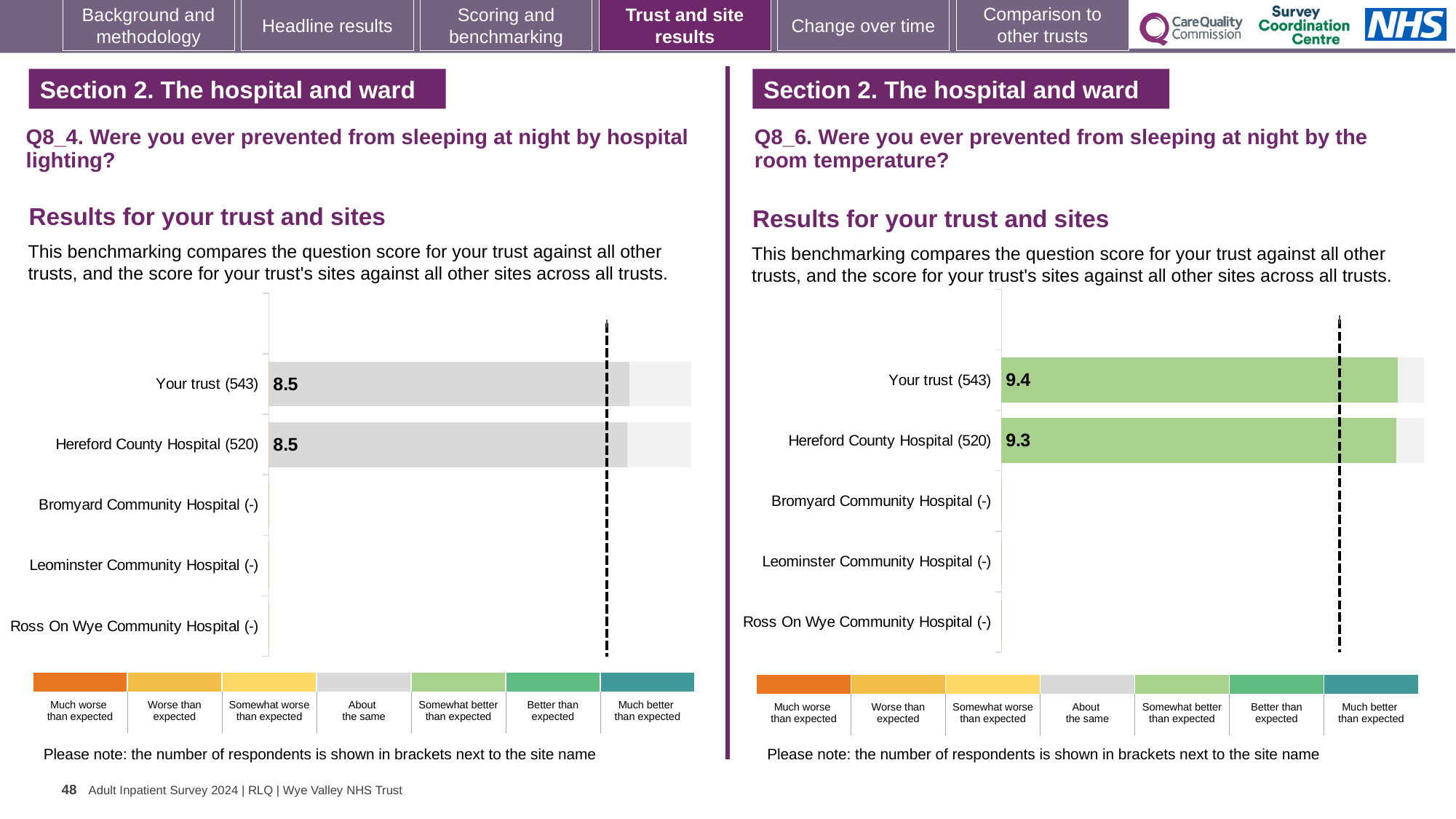
In the Q8_4 chart (hospital lighting), what is the score for Your trust? 8.5 What type of chart is used in the Q8_6 chart (room temperature)? Bar chart In the Q8_6 chart (room temperature), what is the score for Your trust? 9.4 In the Q8_6 chart (room temperature), which benchmark category does the colour of the Your trust bar correspond to according to the legend? Somewhat better than expected How many respondents are shown in brackets for Hereford County Hospital in the Q8_4 chart (hospital lighting)? 520 In the Q8_4 chart (hospital lighting), what is the score for Hereford County Hospital? 8.5 What is the difference between the Your trust score in the Q8_6 chart (room temperature) and the Your trust score in the Q8_4 chart (hospital lighting)? 0.9 How many site/trust categories are listed on the y axis of the Q8_4 chart (hospital lighting)? 5 In the Q8_6 chart (room temperature), what is the difference between the Your trust score and the Hereford County Hospital score? 0.1 In the Q8_4 chart (hospital lighting), which benchmark category does the colour of the Your trust bar correspond to according to the legend? About the same In the Q8_6 chart (room temperature), which has the higher score, Your trust or Hereford County Hospital? Your trust In the Q8_6 chart (room temperature), what is the score for Hereford County Hospital? 9.3